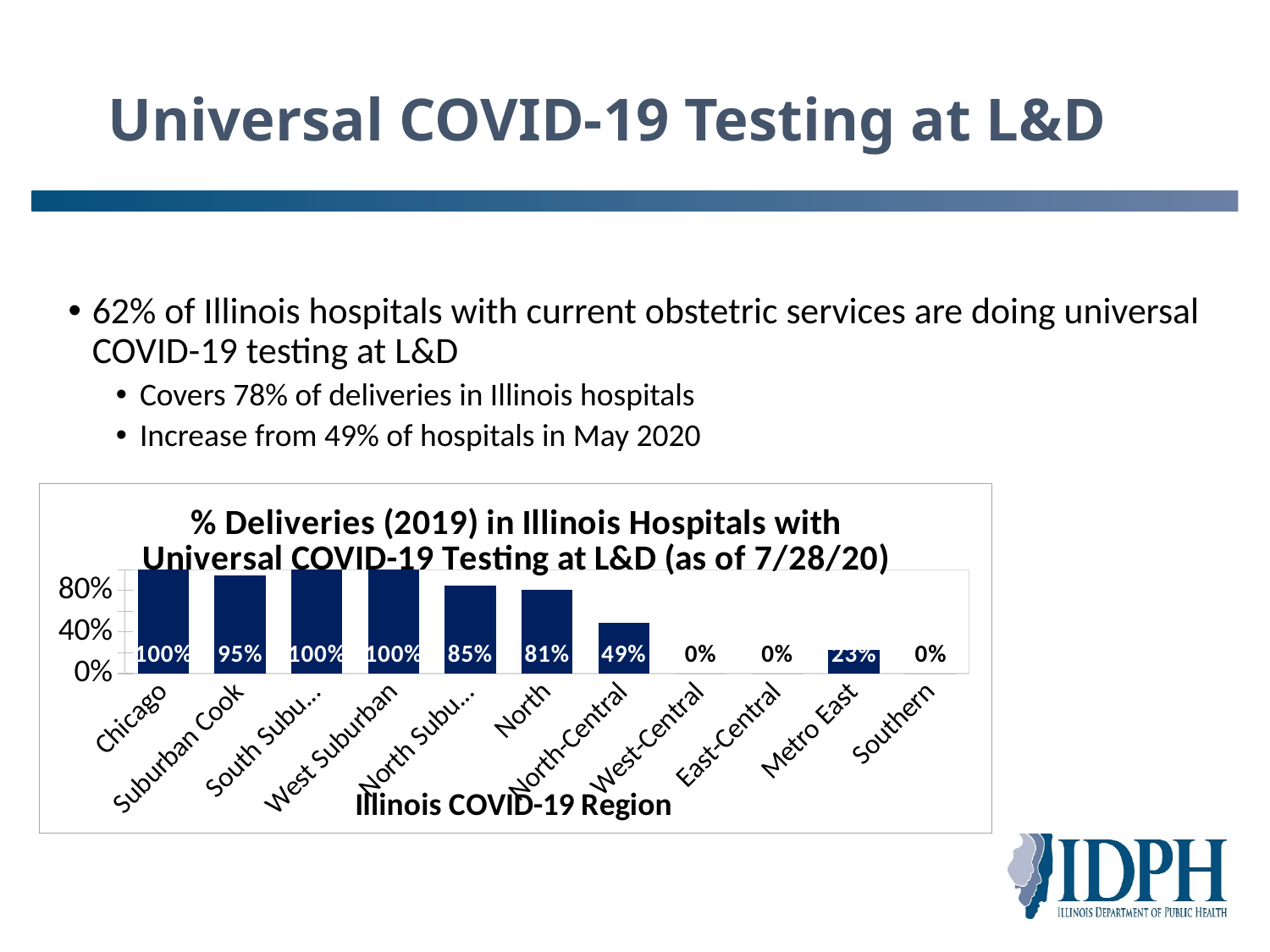
What is the difference between the values for Chicago and North? 19% What is the value for Chicago? 100% What is the title of the x axis? Illinois COVID-19 Region What is the value for North-Central? 49% What is the value for West-Central? 0% How many regions are shown on the x axis? 11 Which is larger, the value for West Suburban or the value for North? West Suburban What is the difference between the values for Suburban Cook and North-Central? 46% What is the value for North? 81% What is the value for Metro East? 23% What kind of chart is shown? Bar chart What is the value for Suburban Cook? 95%